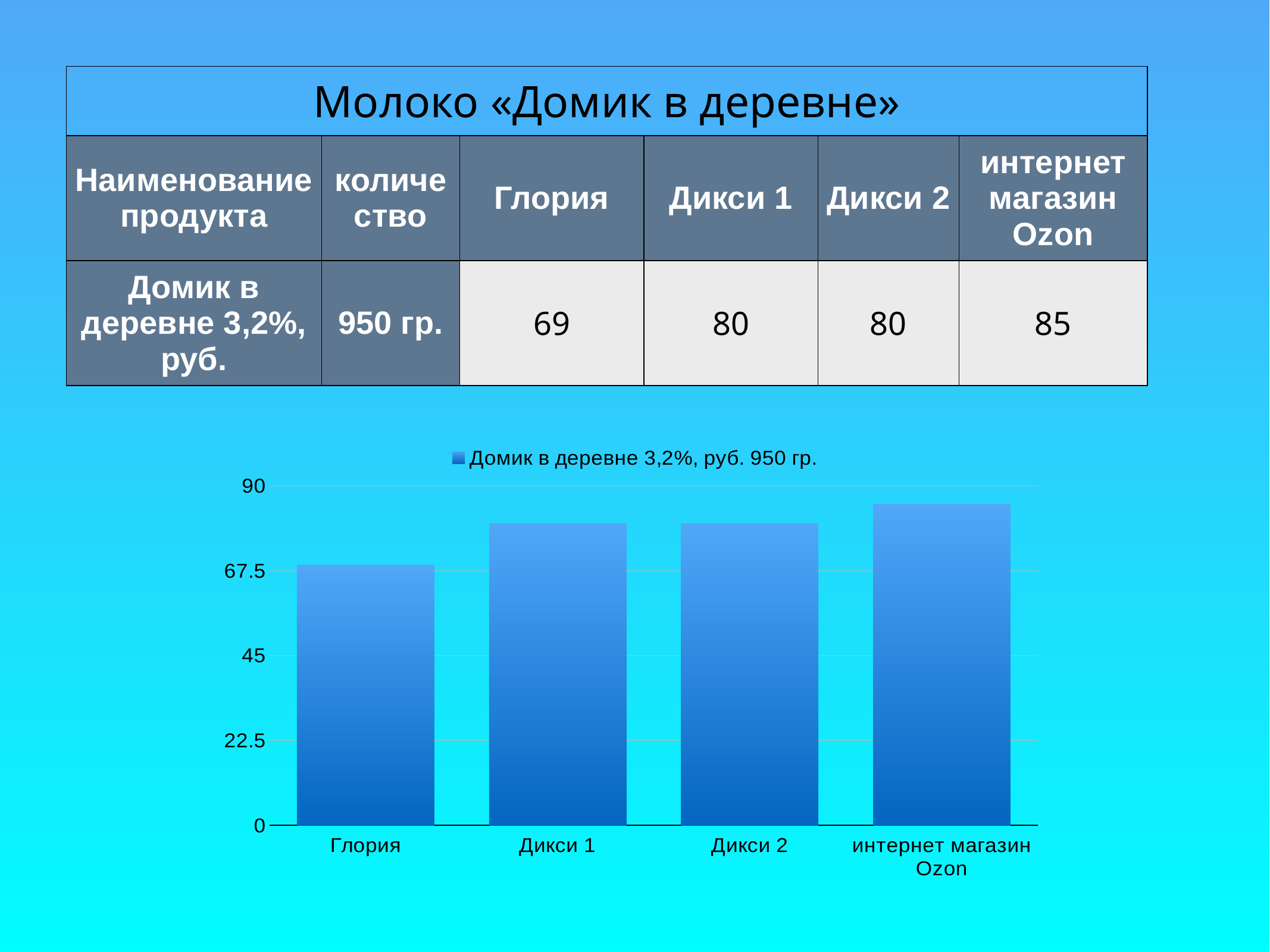
Is the value for Дикси 1 greater or less than 67.5? greater What is the legend entry of the chart? Домик в деревне 3,2%, руб. 950 гр. Is the value for Глория greater or less than 67.5? greater Which category has the lowest bar in the chart? Глория According to the table, what is the price of Домик в деревне 3,2% at Глория? 69 According to the table, what is the difference between the price at интернет магазин Ozon and the price at Глория? 16 What kind of chart is shown on the slide? bar chart Which is larger, the value for Глория or the value for Дикси 2? Дикси 2 How many series does the chart legend list? 1 Which category has the highest bar in the chart? интернет магазин Ozon How many categories are shown on the x axis of the chart? 4 Is the value for интернет магазин Ozon greater or less than 90? less